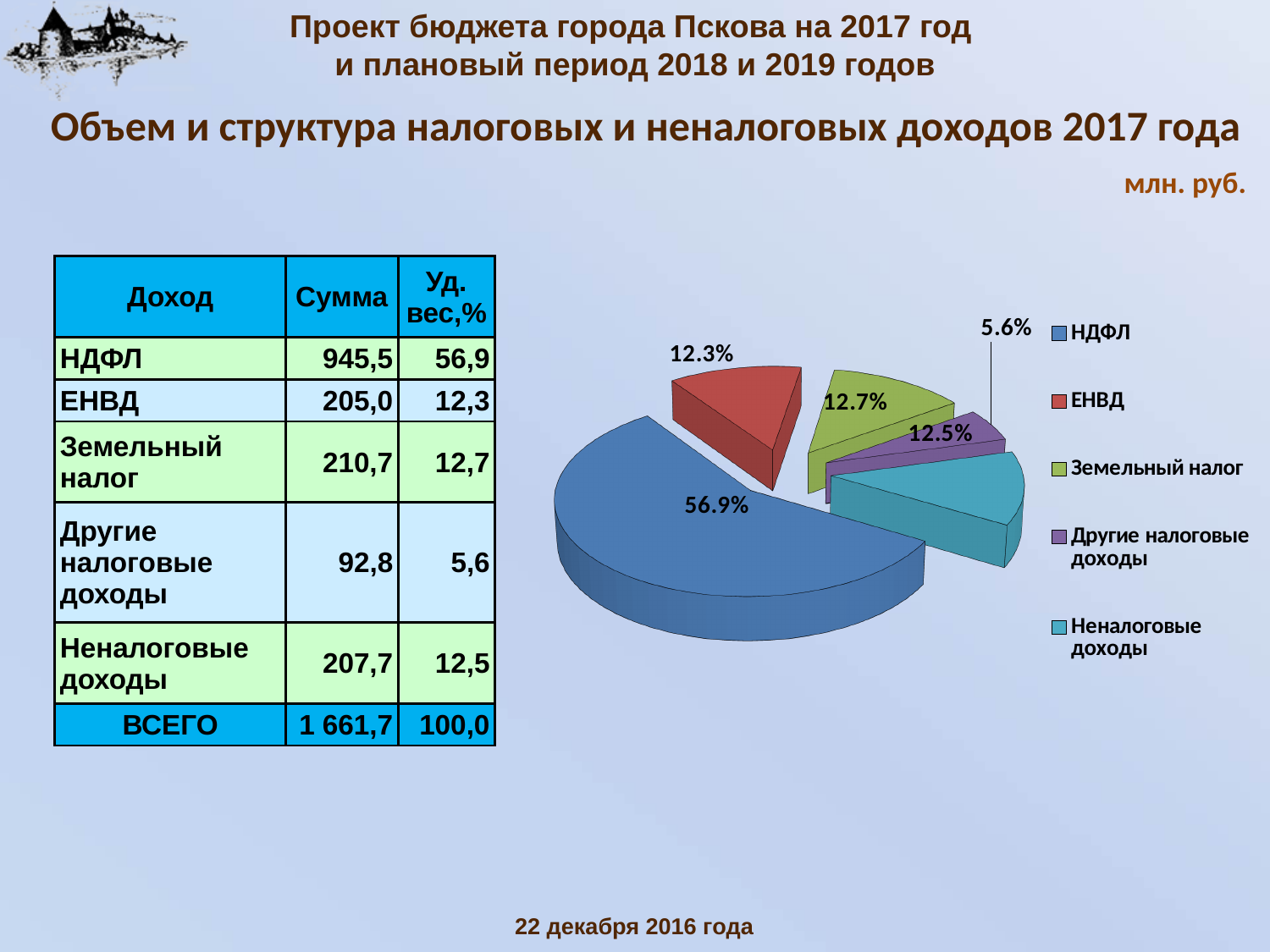
What share of the pie does Другие налоговые доходы account for? 5.6% What share of the pie does НДФЛ account for? 56.9% What colour is the НДФЛ slice in the pie chart? Blue By how many percentage points does the НДФЛ share exceed the ЕНВД share? 44.6 Which category has the smallest slice of the pie? Другие налоговые доходы Which slice is larger, НДФЛ or ЕНВД? НДФЛ What share of the pie does ЕНВД account for? 12.3% What share of the pie does Неналоговые доходы account for? 12.5% How many slices does the pie chart have? 5 Which category has the largest slice of the pie? НДФЛ What share of the pie does Земельный налог account for? 12.7% What type of chart is shown on the slide? Pie chart